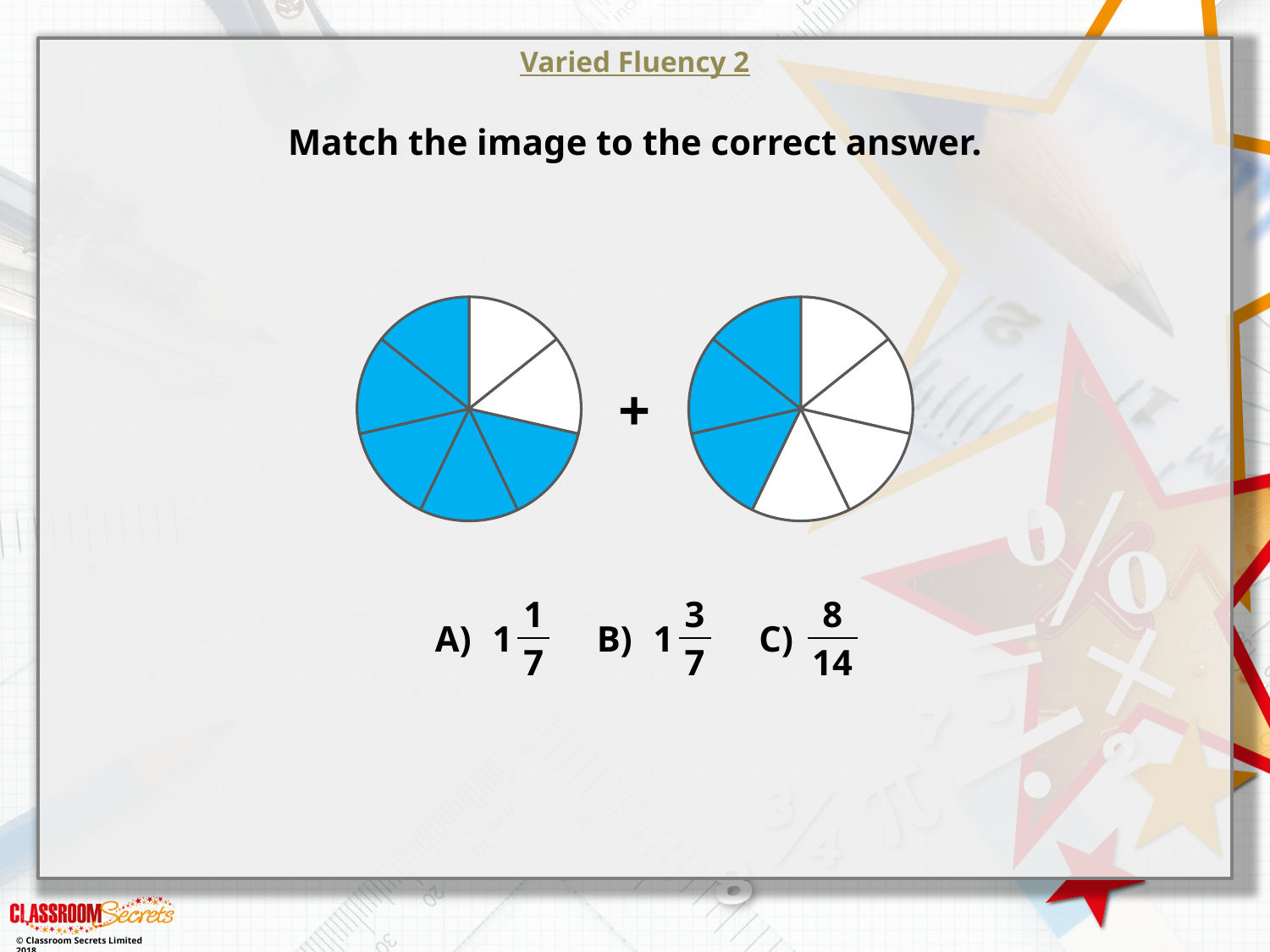
How many equal sections is the right circle divided into? 7 How many equal sections is the left circle divided into? 7 What colour are the shaded sections of the circles? blue How many sections of the left circle are left white? 2 What symbol is shown between the two circles? + Which circle has more blue shaded sections, the left or the right? left How many more blue sections does the left circle have than the right circle? 2